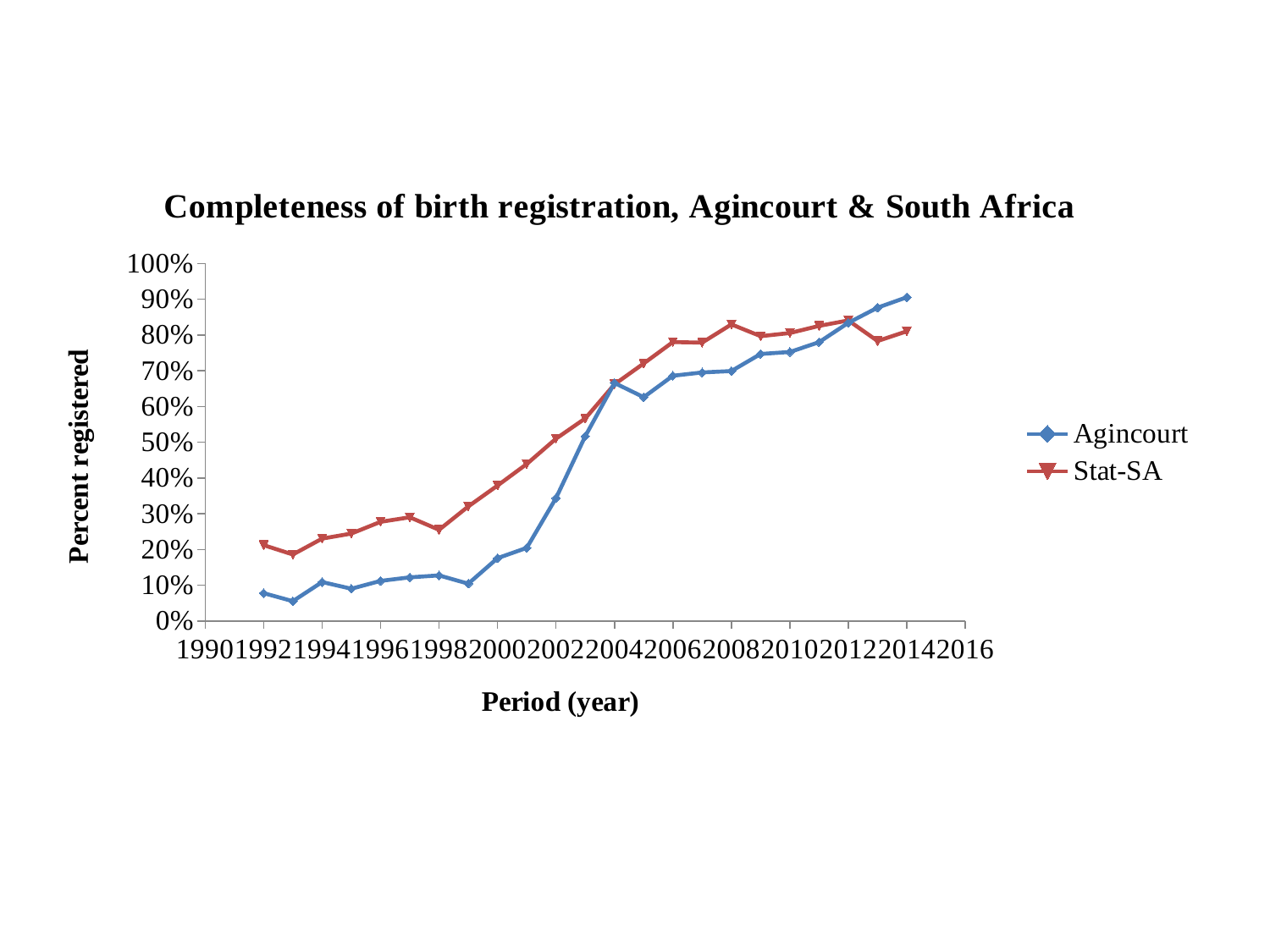
In which year does the Agincourt series reach its highest value? 2014 What kind of chart is shown on the slide? line chart What is the label of the y axis? Percent registered Is the Agincourt value for 1993 greater or less than 10%? less What is the title of the chart? Completeness of birth registration, Agincourt & South Africa Is the Agincourt value for 2000 greater or less than 20%? less Do the Agincourt values generally rise or fall from 1992 to 2014? rise In 2014, which series has the higher value, Agincourt or Stat-SA? Agincourt Is the Agincourt value for 2014 greater or less than 80%? greater How many series does the legend list? 2 In 1992, which series has the higher value, Agincourt or Stat-SA? Stat-SA